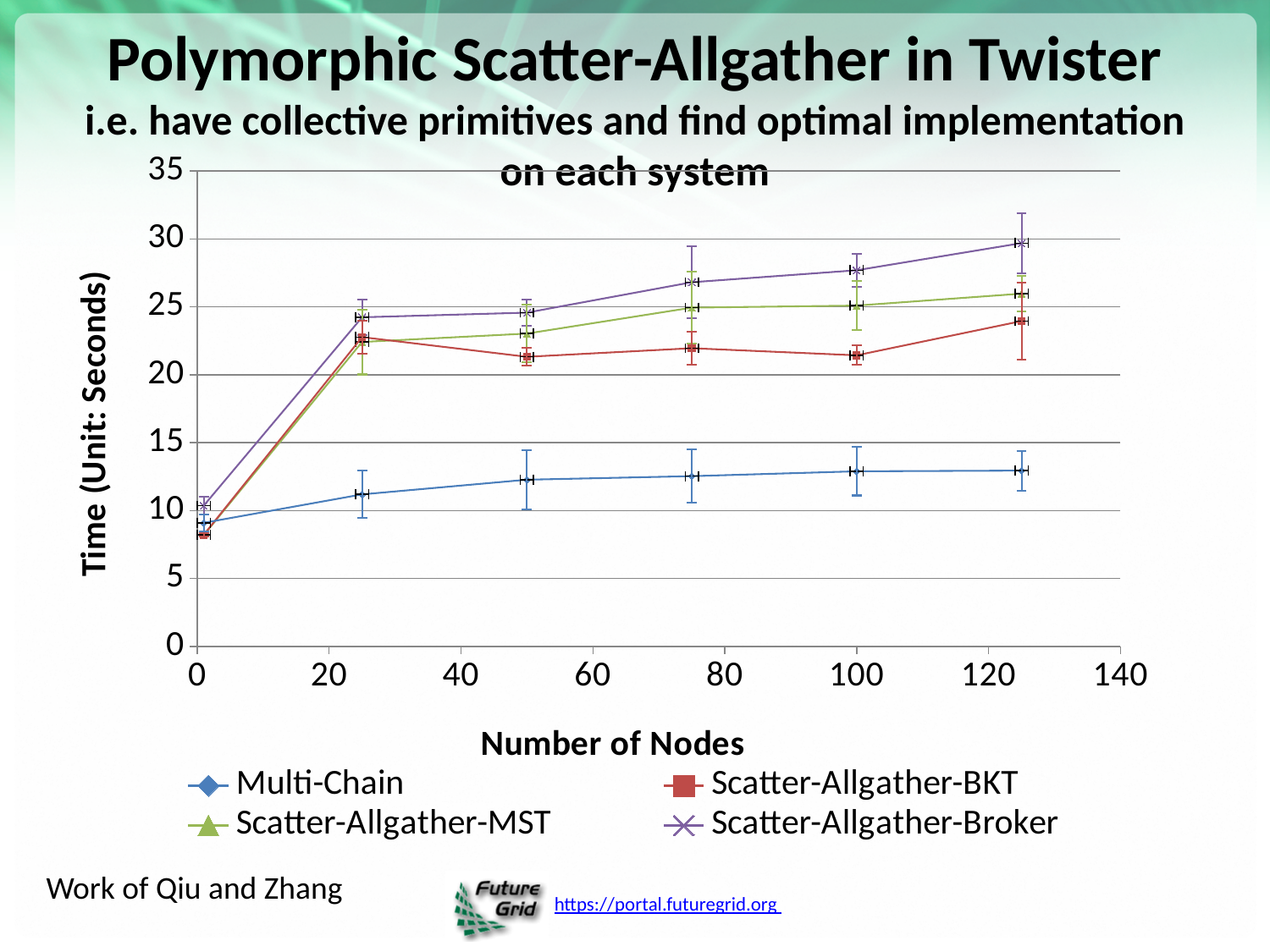
How many data points are plotted for the Multi-Chain series? 6 At 100 nodes, which is larger: Scatter-Allgather-MST or Scatter-Allgather-BKT? Scatter-Allgather-MST Is the value for Scatter-Allgather-BKT at 100 nodes greater or less than 20? greater Is the value for Scatter-Allgather-Broker at 100 nodes greater or less than 25? greater Is the value for Multi-Chain at 125 nodes greater or less than 15? less How many series does the legend list? 4 Which series has the highest time at 125 nodes? Scatter-Allgather-Broker What is the label of the y axis? Time (Unit: Seconds) Does the Scatter-Allgather-Broker series generally rise or fall as the number of nodes increases? rise Which series has the lowest time at 125 nodes? Multi-Chain What kind of chart is shown on the slide? line chart What is the label of the x axis? Number of Nodes